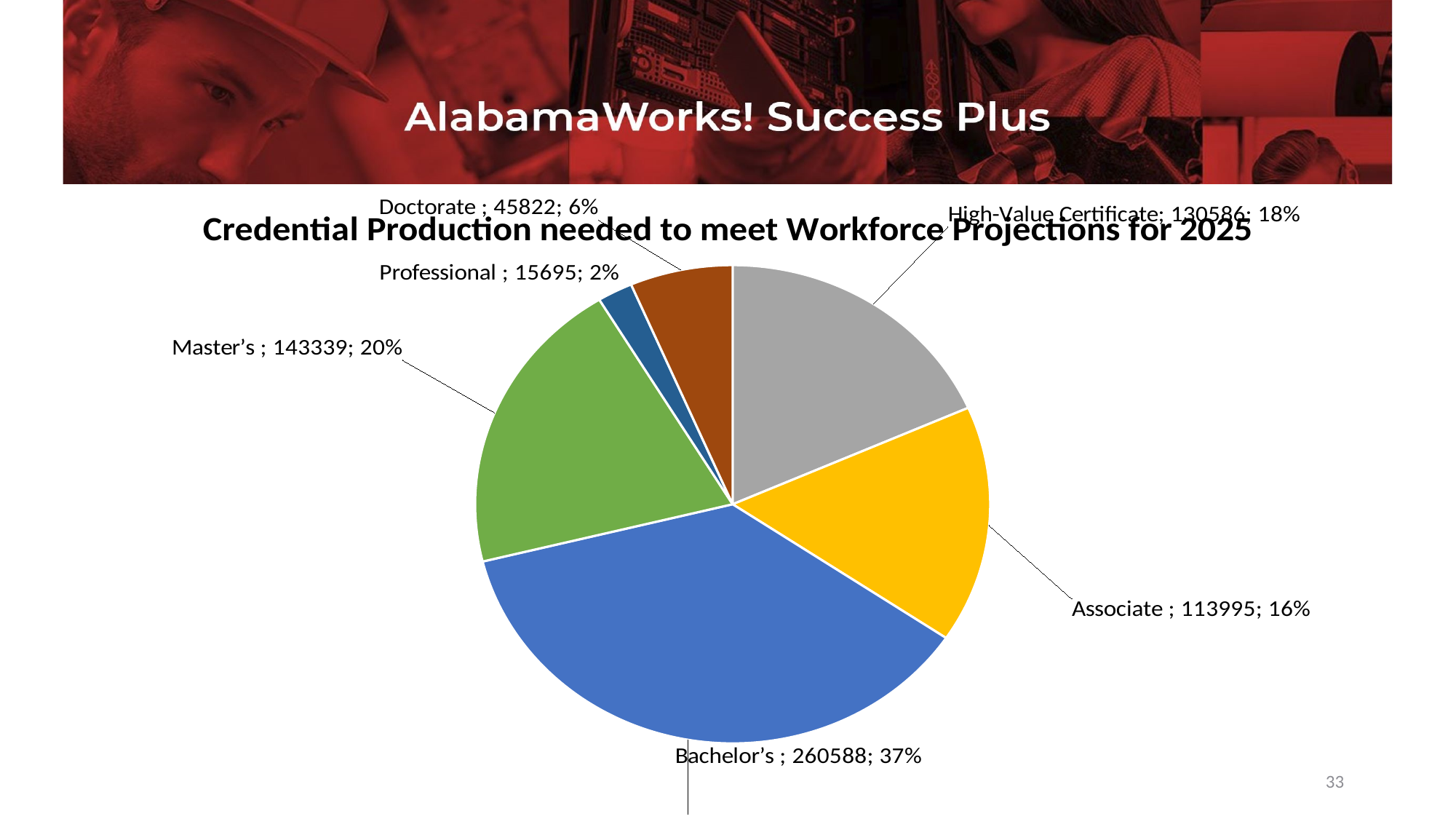
Which is larger, the value for High-Value Certificate or the value for Associate? High-Value Certificate What share of the pie does Master's represent? 20% What is the title of the chart? Credential Production needed to meet Workforce Projections for 2025 Which category has the smallest slice? Professional What type of chart is shown on the slide? Pie chart How many slices does the pie chart have? 6 Which category has the largest slice? Bachelor's What is the value for Professional? 15695 What share of the pie does Doctorate represent? 6% What is the difference between the values for Bachelor's and Master's? 117249 What is the value for High-Value Certificate? 130586 What is the value for Bachelor's? 260588